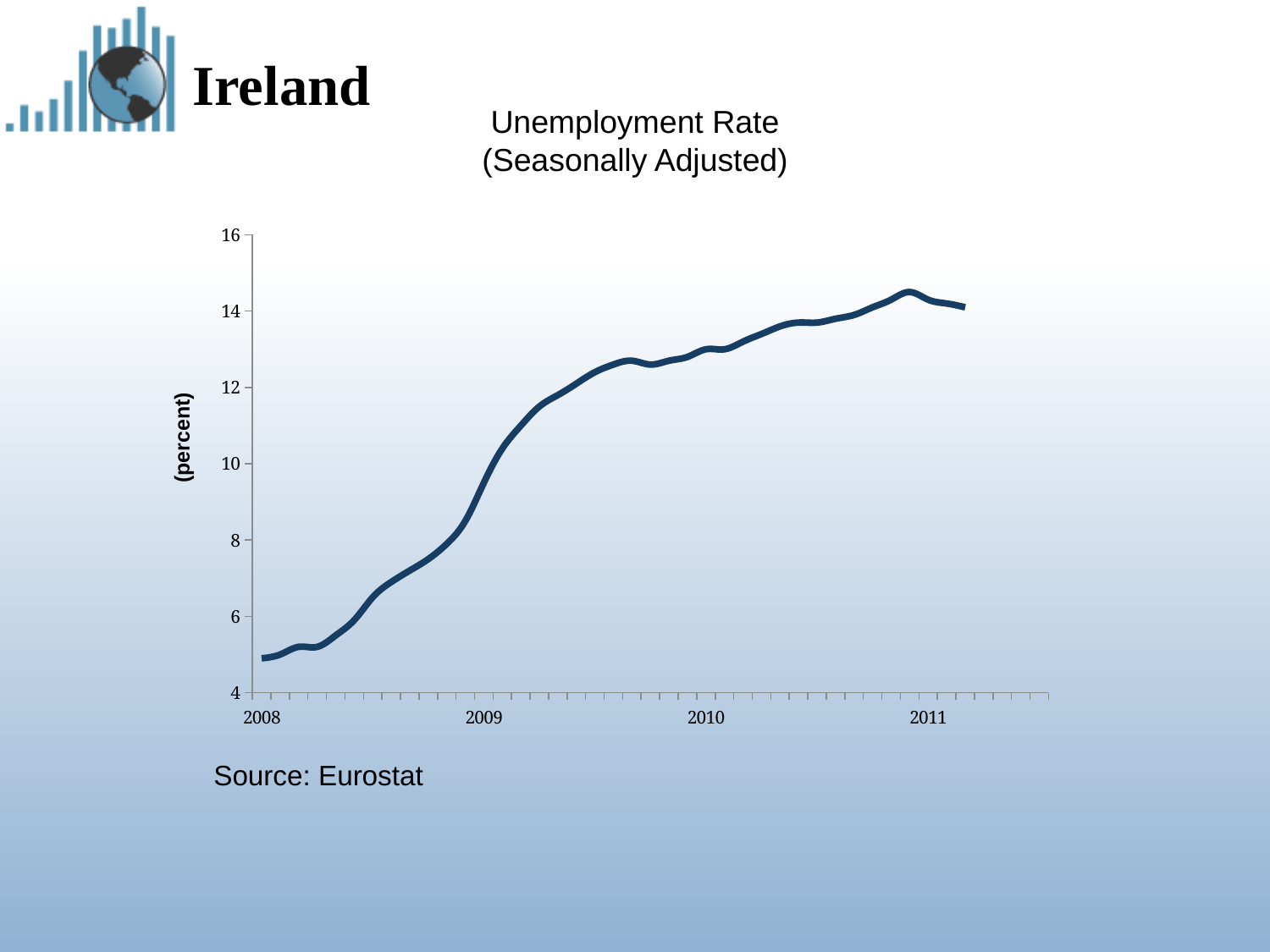
Is the unemployment rate at the start of 2009 greater or less than 8? greater Does the unemployment rate generally rise or fall from 2008 to 2011? rise What is the title of the chart? Unemployment Rate (Seasonally Adjusted) Is the unemployment rate higher at the start of 2010 or at the start of 2008? start of 2010 Is the unemployment rate at the start of 2010 greater or less than 12? greater Is the highest point of the line greater or less than 16? less What kind of chart is shown on the slide? line chart How many year labels are shown on the x axis? 4 How many lines are plotted on the chart? 1 What is the label on the vertical axis? (percent)